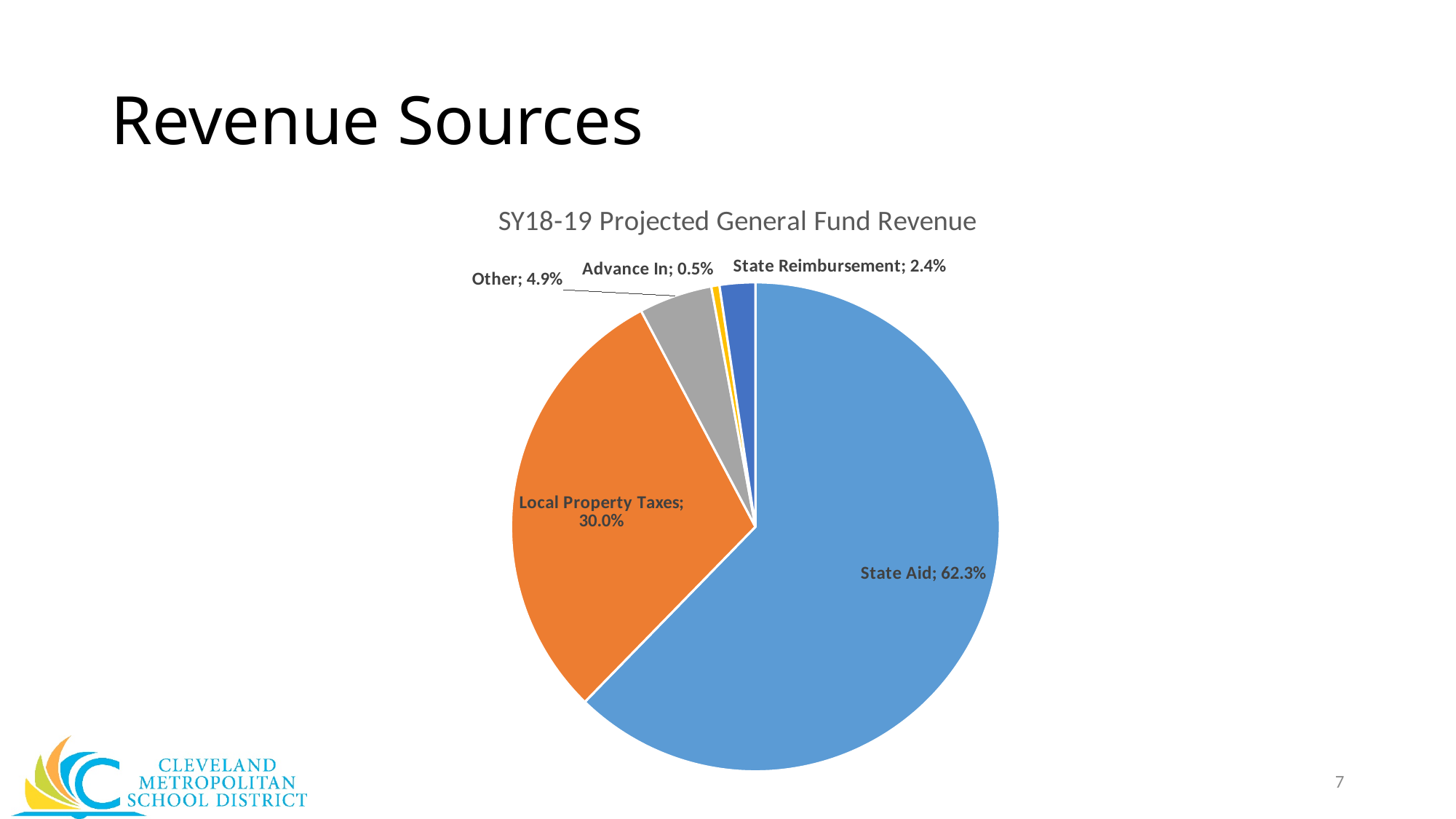
What share of SY18-19 Projected General Fund Revenue comes from State Aid? 62.3% Which revenue source has the largest share of the pie? State Aid How many slices does the pie chart have? 5 What percentage of the pie is labelled Advance In? 0.5% Which revenue source has the smallest share of the pie? Advance In Which is larger, the share for Other or the share for State Reimbursement? Other What percentage of the pie is labelled State Reimbursement? 2.4% What kind of chart is shown on the slide? Pie chart What percentage of the pie is labelled Other? 4.9% How many percentage points larger is State Aid's share than Local Property Taxes' share? 32.3 What is the title of the chart? SY18-19 Projected General Fund Revenue What share of SY18-19 Projected General Fund Revenue comes from Local Property Taxes? 30.0%